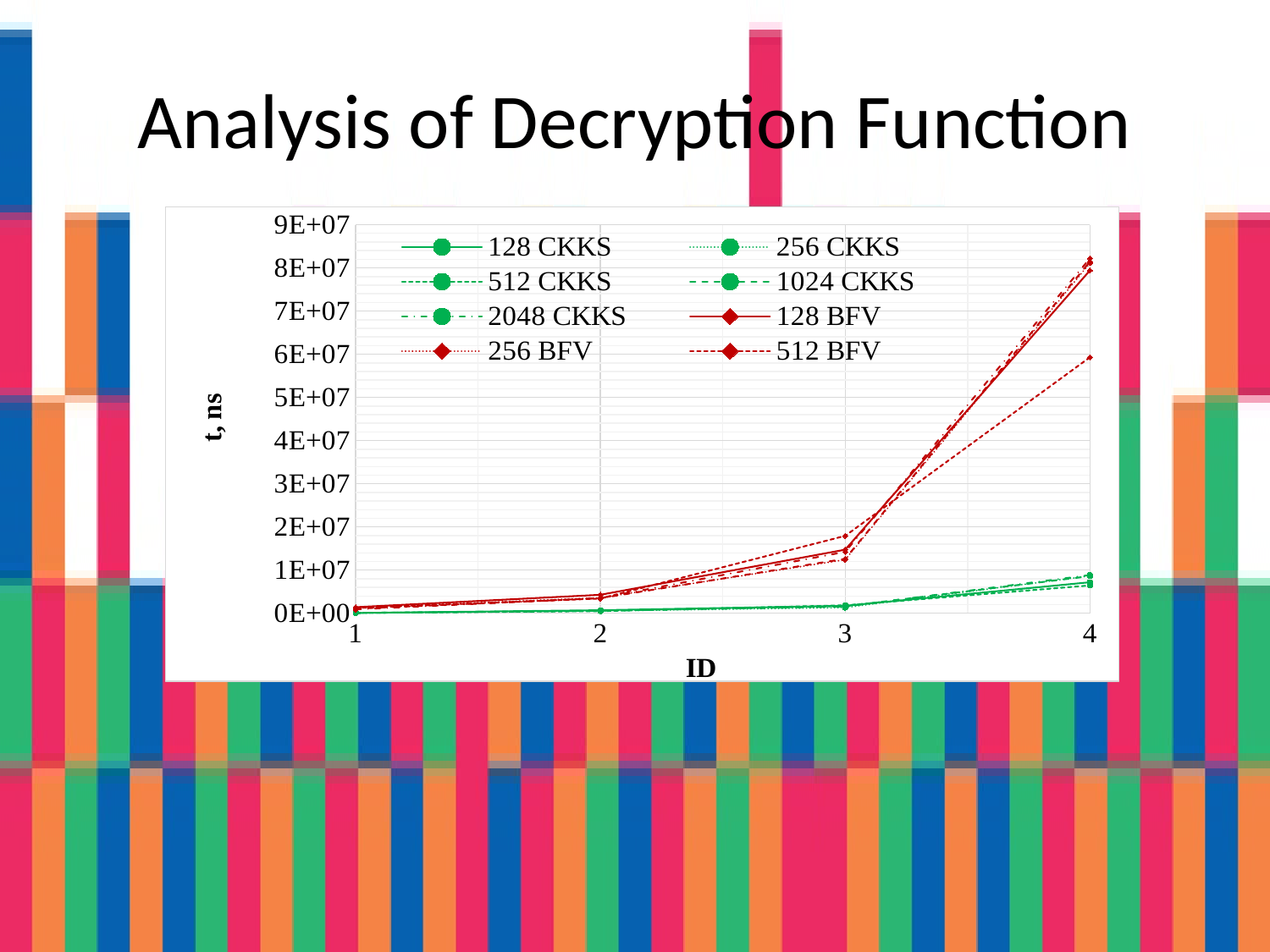
Is the value for 256 BFV at ID 3 greater or less than 3E+07? less Is the value for 128 CKKS at ID 4 greater or less than 2E+07? less What kind of chart is shown on the slide? line chart Do the values for 128 BFV rise or fall as ID increases from 1 to 4? rise How many series does the chart legend list? 8 Is the value for 512 BFV at ID 4 greater or less than 5E+07? greater At ID 4, which is larger: the value for 512 BFV or the value for 2048 CKKS? 512 BFV Among the BFV series, which has the lowest value at ID 4? 512 BFV How many ID values are plotted along the x axis? 4 What is the label of the chart's y axis? t, ns At ID 4, which is larger: the value for 128 BFV or the value for 512 BFV? 128 BFV